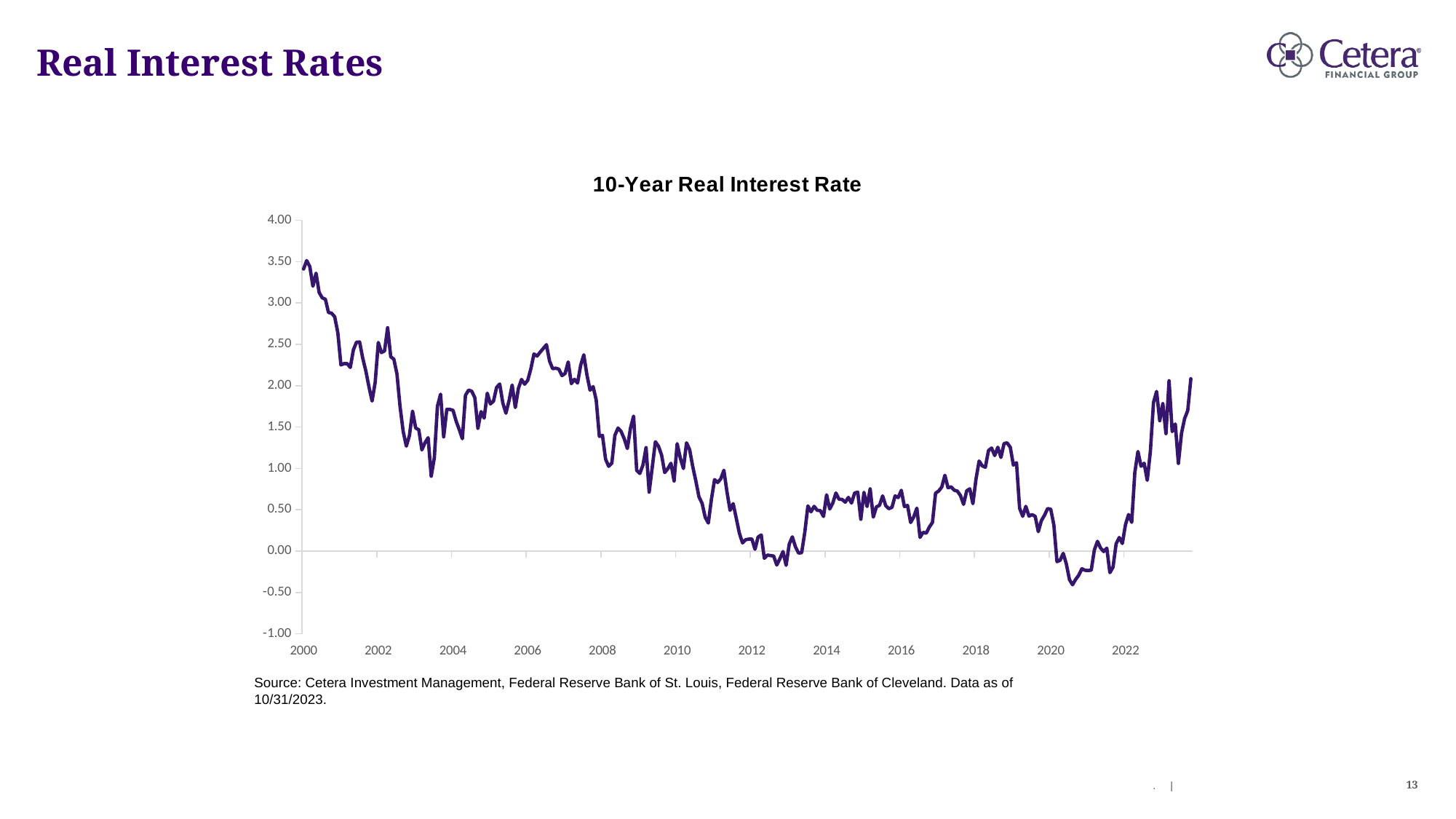
In which year shown on the x axis does the 10-year real interest rate reach its highest value? 2000 Does the 10-year real interest rate generally rise or fall between 2000 and 2012? fall Is the value of the 10-year real interest rate at the end of the series in 2023 greater or less than 1.50? greater Is the lowest value of the 10-year real interest rate around 2020 greater or less than 0.00? less Does the 10-year real interest rate generally rise or fall between 2021 and 2023? rise What kind of chart is shown on the slide? line chart How many lines (series) are plotted on the chart? 1 Is the value of the 10-year real interest rate at the start of 2000 greater or less than 3.00? greater What is the title of the chart? 10-Year Real Interest Rate What is the highest value shown on the y axis of the chart? 4.00